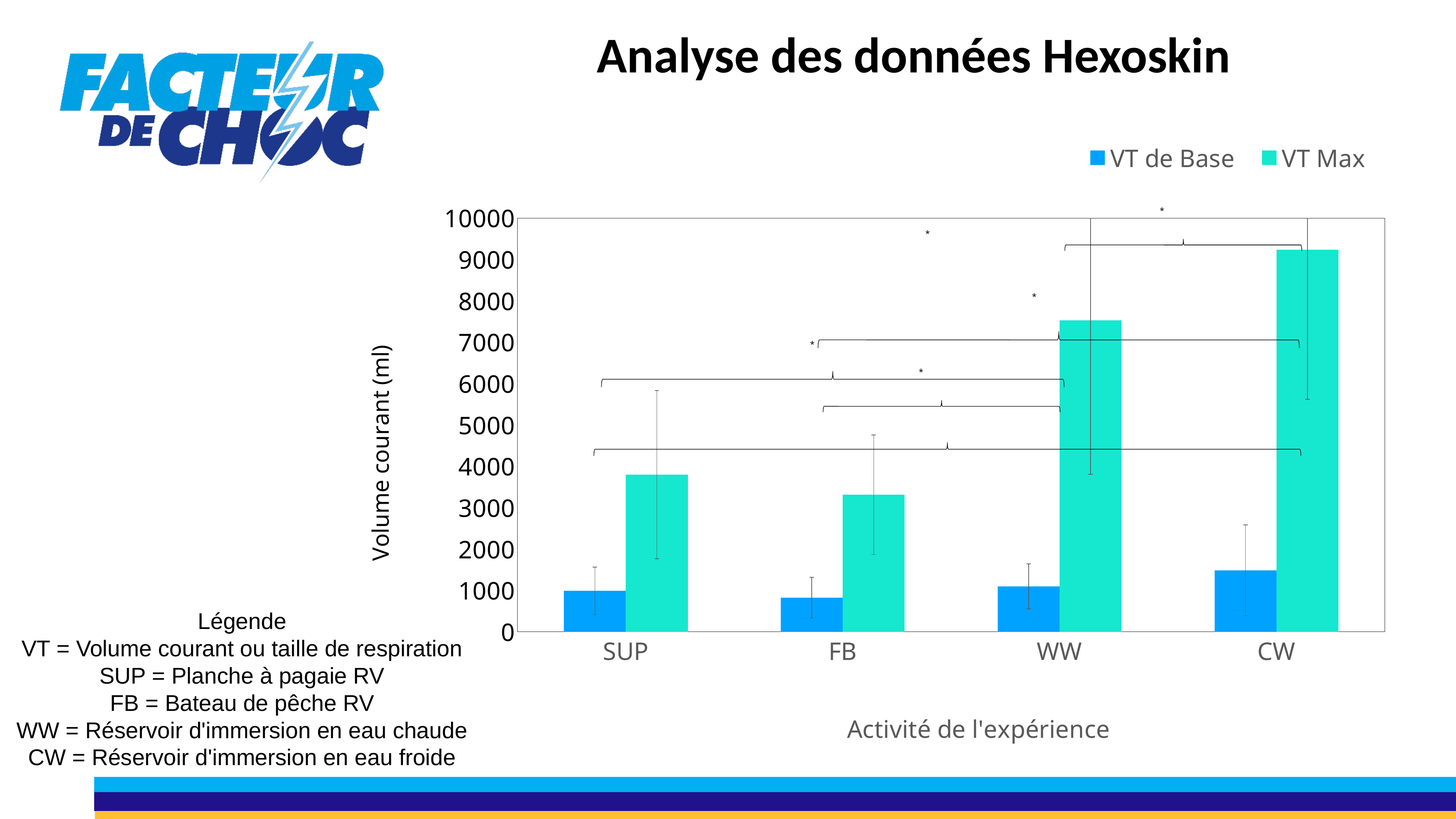
What is the label of the y axis? Volume courant (ml) Is the VT de Base value for FB greater or less than 1000? less Which is larger, the VT de Base value for SUP or for CW? CW What kind of chart is shown on the slide? bar chart Which is larger, the VT Max value for WW or for CW? CW Which activity has the highest VT Max value? CW How many series does the legend list? 2 Which activity has the highest VT de Base value? CW Is the VT Max value for WW greater or less than 7000? greater How many activity categories are shown on the x axis? 4 Which activity has the lowest VT Max value? FB Is the VT Max value for SUP greater or less than 4000? less